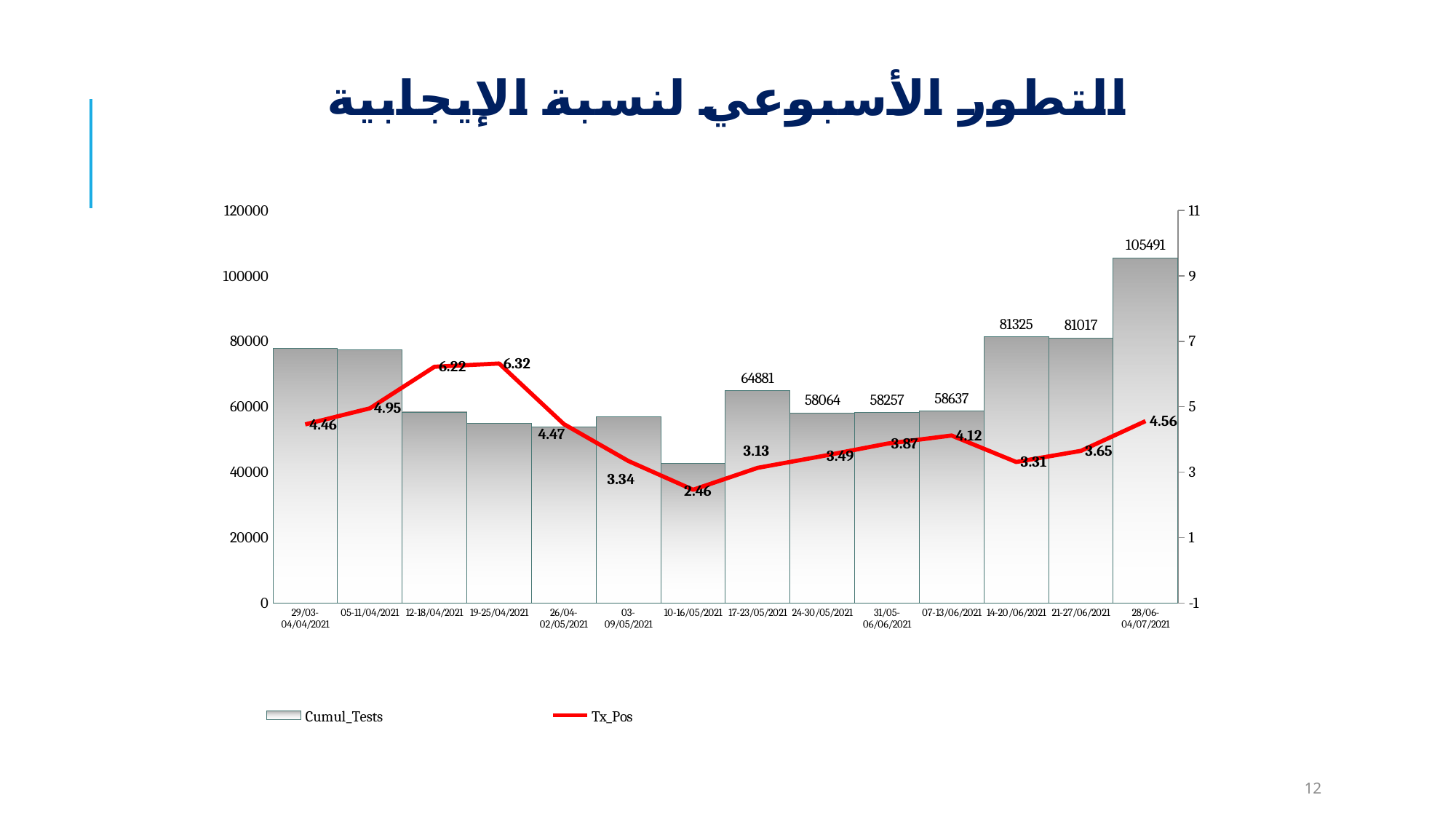
Which is larger, the Tx_Pos value for 17-23/05/2021 or for 24-30/05/2021? 24-30/05/2021 Which week has the lowest Tx_Pos value? 10-16/05/2021 What is the Tx_Pos value for the week 10-16/05/2021? 2.46 Which week has the highest Tx_Pos value? 19-25/04/2021 Which series is drawn as a red line? Tx_Pos How many series does the legend list? 2 Which week has the highest Cumul_Tests value? 28/06-04/07/2021 What is the difference in Cumul_Tests between the weeks 14-20/06/2021 and 21-27/06/2021? 308 Is the Cumul_Tests value for the week 29/03-04/04/2021 greater or less than 60000? greater What is the Cumul_Tests value for the week 28/06-04/07/2021? 105491 How many weeks are shown on the x axis? 14 What is the Tx_Pos value for the week 19-25/04/2021? 6.32